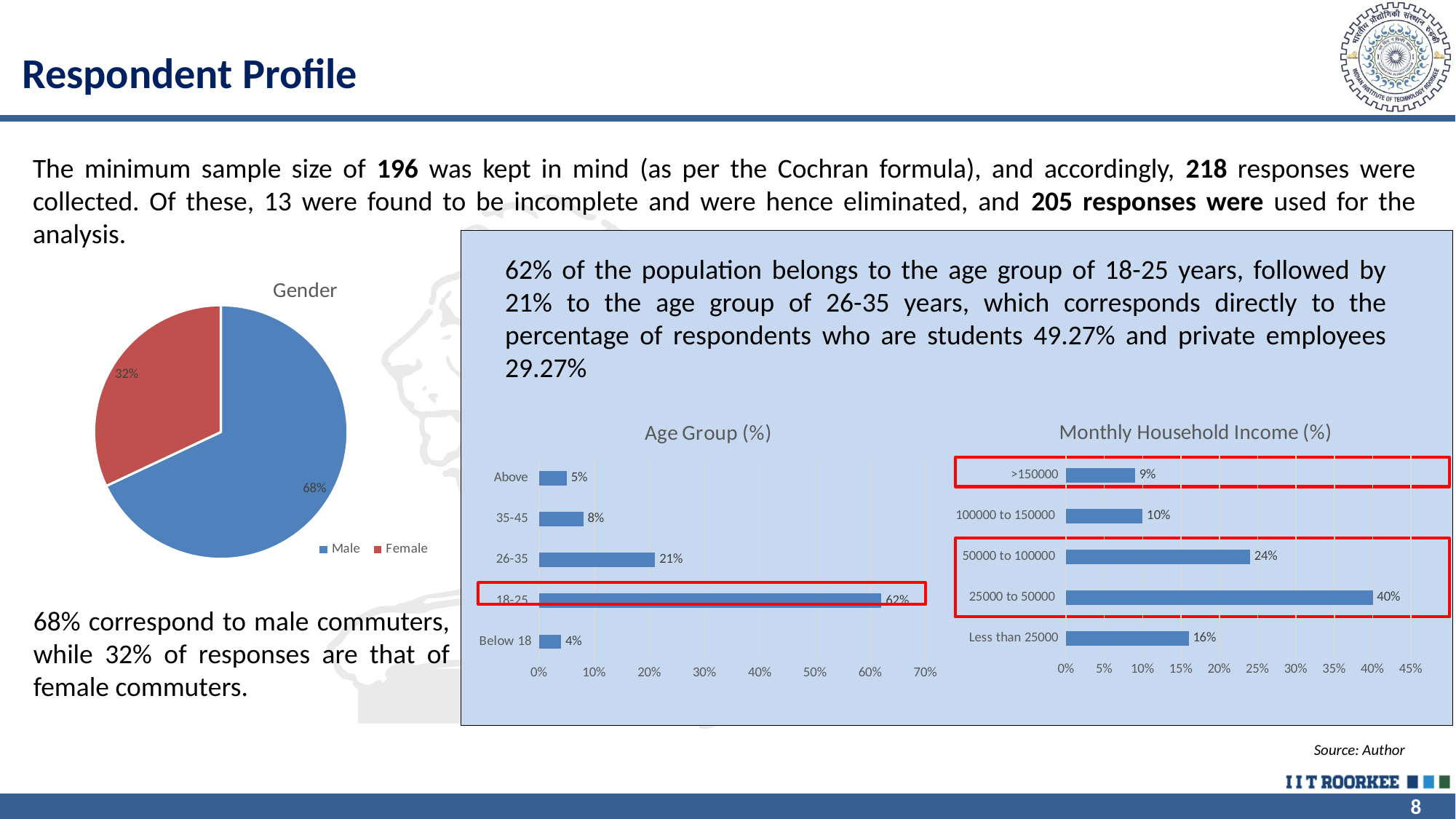
In the Gender chart, what share of respondents are Male? 68% In the Monthly Household Income (%) chart, which is larger: the value for Less than 25000 or the value for 100000 to 150000? Less than 25000 What kind of chart is the Age Group (%) chart? bar chart In the Gender chart, what share of respondents are Female? 32% In the Monthly Household Income (%) chart, what is the value for 25000 to 50000? 40% How many age groups are shown in the Age Group (%) chart? 5 In the Monthly Household Income (%) chart, which income category has the highest value? 25000 to 50000 In the Age Group (%) chart, which age group has the lowest value? Below 18 In the Age Group (%) chart, what is the value for 18-25? 62% In the Age Group (%) chart, what is the difference between the values for 26-35 and 35-45? 13% What kind of chart is the Gender chart? pie chart In the Monthly Household Income (%) chart, what is the difference between the values for 50000 to 100000 and >150000? 15%